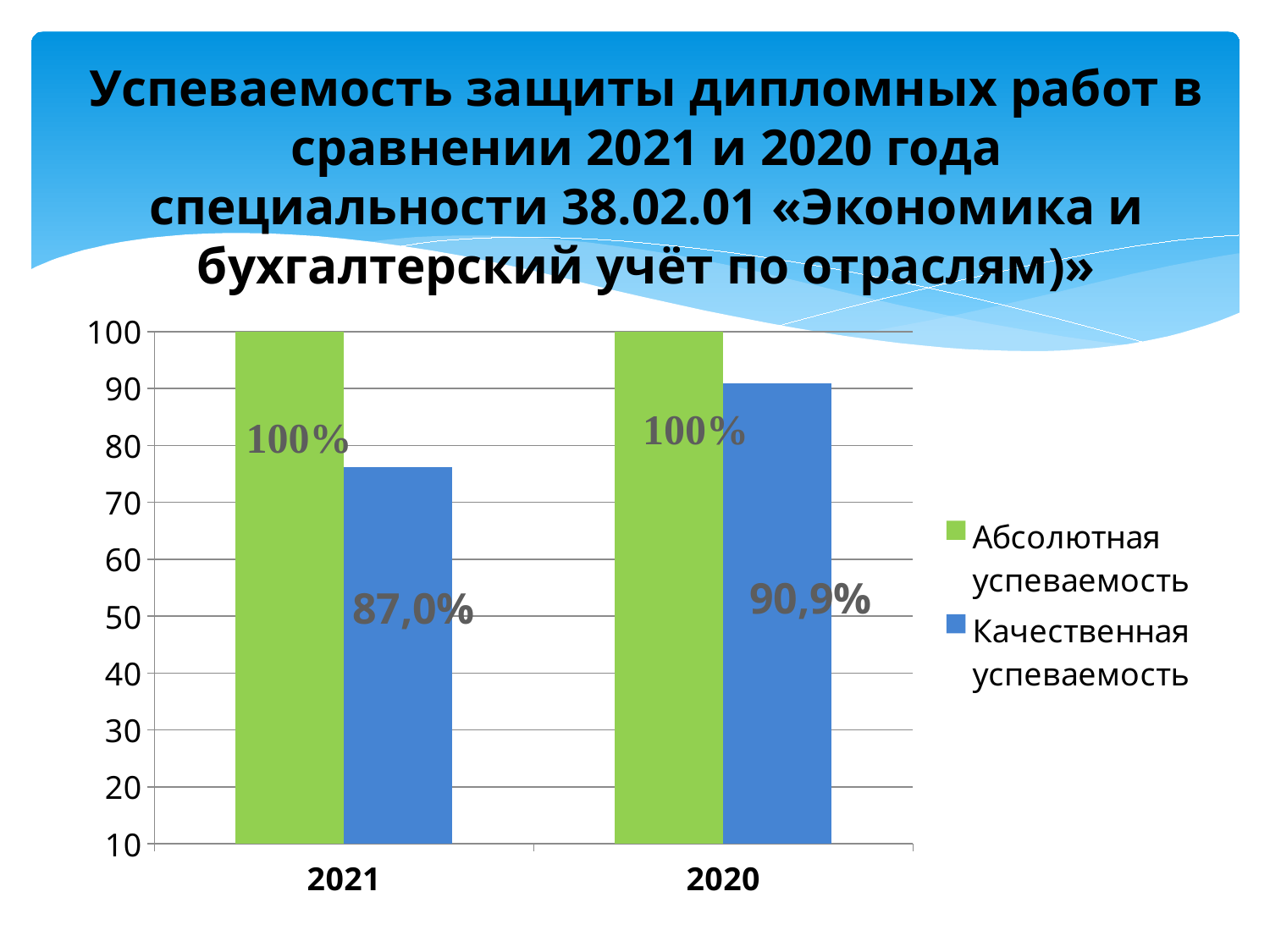
How many series does the legend list? 2 What is the value of Абсолютная успеваемость for 2021? 100% What is the value of Абсолютная успеваемость for 2020? 100% Is the value of Качественная успеваемость for 2020 greater or less than 80? greater What is the difference between Качественная успеваемость in 2020 and in 2021? 3,9% What is the value of Качественная успеваемость for 2020? 90,9% What type of chart is shown on the slide? Bar chart Which series is shown in blue in the legend? Качественная успеваемость What is the value of Качественная успеваемость for 2021? 87,0% Which series is shown in green in the legend? Абсолютная успеваемость Which year has the higher Качественная успеваемость, 2021 or 2020? 2020 How many year categories are shown on the x axis? 2